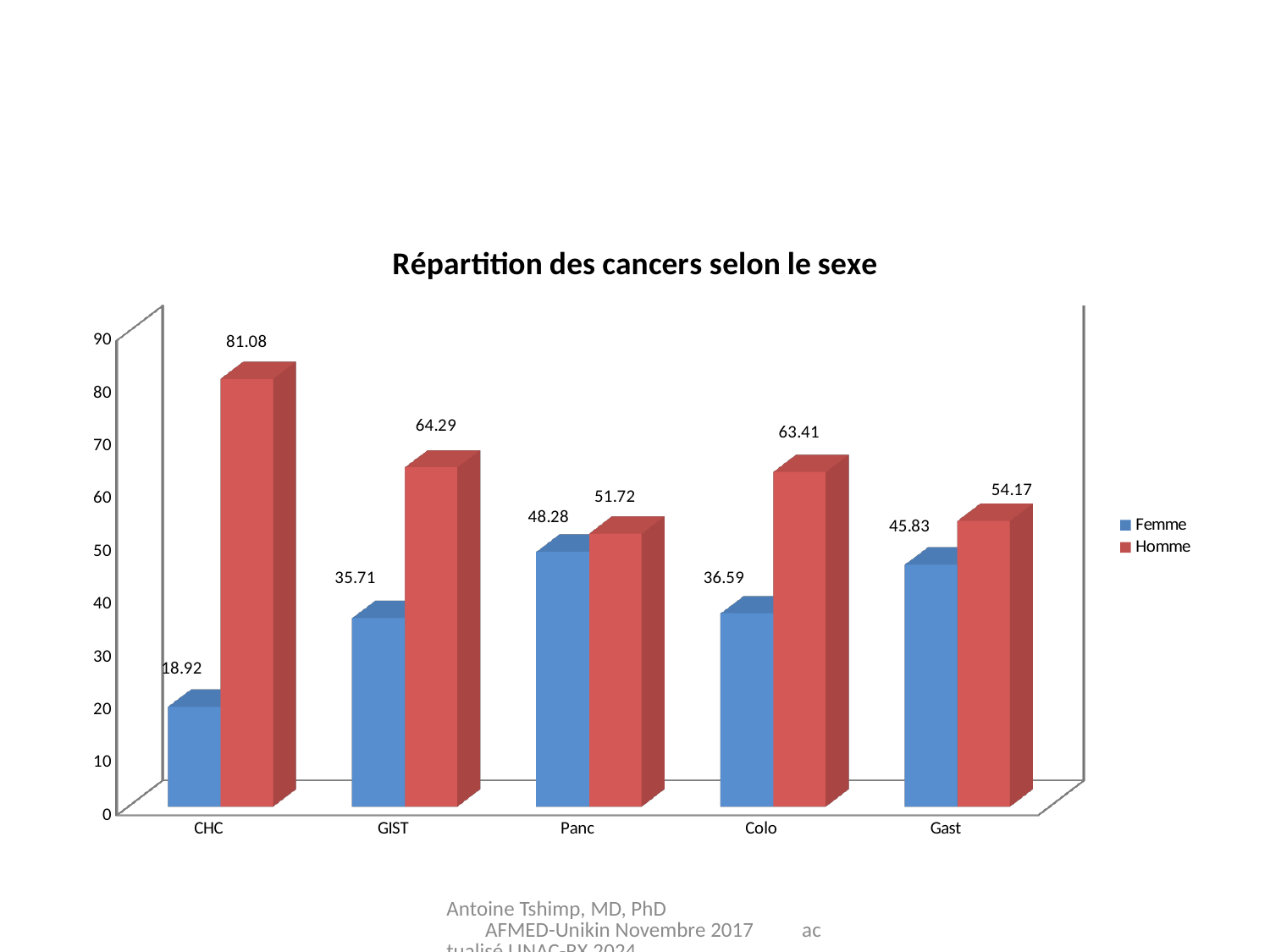
What is the Femme value for Panc? 48.28 What kind of chart is shown on the slide? bar chart What is the difference between the Homme and Femme values for CHC? 62.16 What is the Homme value for CHC? 81.08 What is the title of the chart? Répartition des cancers selon le sexe Which category has the highest Homme value? CHC What is the Femme value for Gast? 45.83 How many series does the legend list? 2 Which category has the lowest Femme value? CHC Is the Homme value for GIST greater or less than 60? greater How many categories are shown on the x axis? 5 Which is larger for Colo, the Femme value or the Homme value? Homme